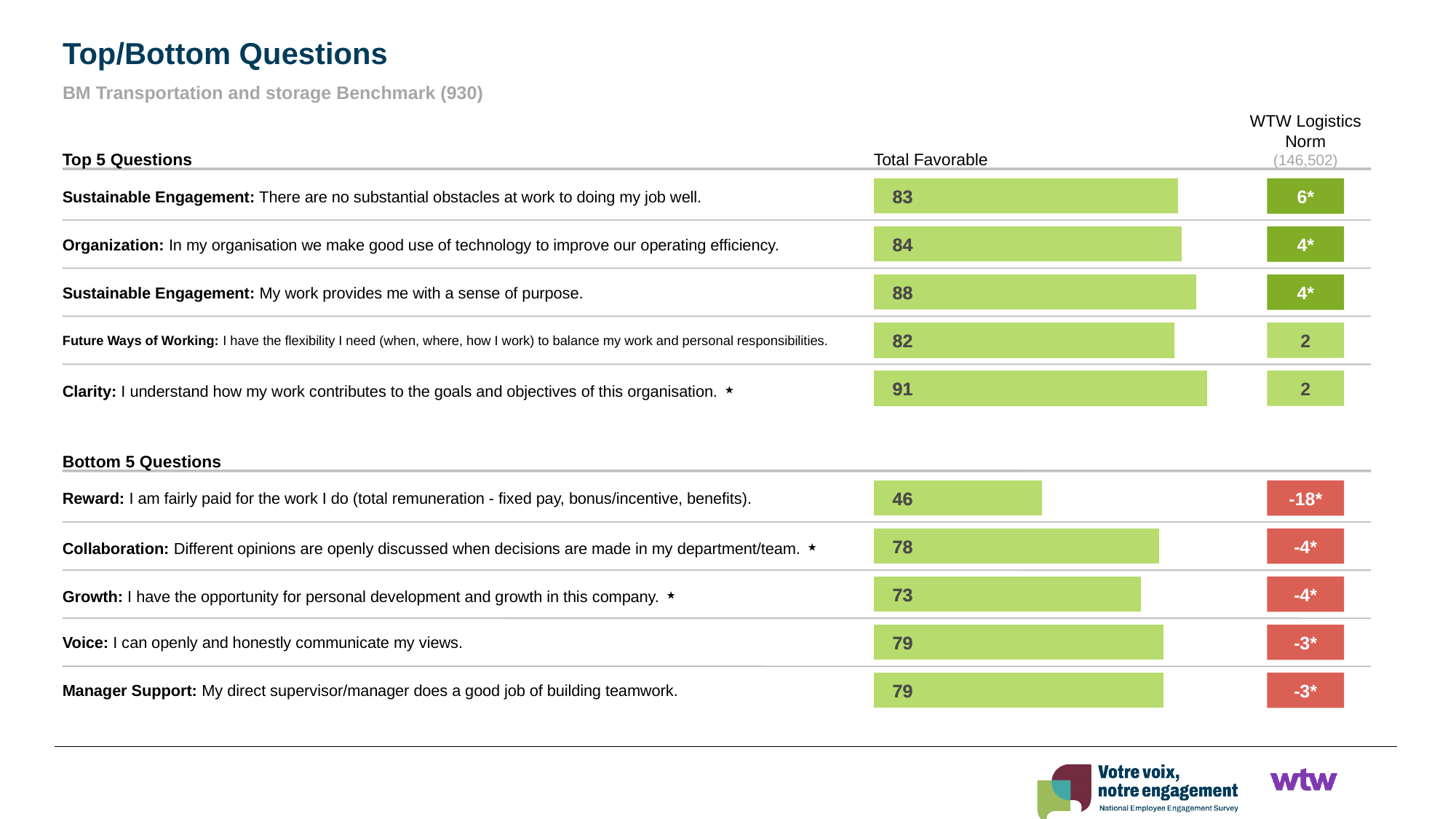
In the Top 5 Questions chart, what is the Total Favorable value for the Clarity item "I understand how my work contributes to the goals and objectives of this organisation"? 91 In the Top 5 Questions chart, which item has the highest Total Favorable value? Clarity: I understand how my work contributes to the goals and objectives of this organisation. In the Top 5 Questions chart, what is the difference in Total Favorable between the Clarity item (91) and the Future Ways of Working item (82)? 9 In the Top 5 Questions chart, what is the WTW Logistics Norm difference shown for the Sustainable Engagement item "There are no substantial obstacles at work to doing my job well"? 6* How many items are plotted in the Bottom 5 Questions chart? 5 In the Bottom 5 Questions chart, which has a larger Total Favorable value: the Collaboration item or the Growth item? Collaboration What is the sample size shown under the WTW Logistics Norm column header? (146,502) What kind of chart is used to show the Total Favorable values on this slide? Bar chart In the Bottom 5 Questions chart, what is the WTW Logistics Norm difference shown for the Reward item? -18* In the Bottom 5 Questions chart, which item has the lowest Total Favorable value? Reward: I am fairly paid for the work I do. In the Bottom 5 Questions chart, what is the Total Favorable value for the Reward item "I am fairly paid for the work I do"? 46 In the Bottom 5 Questions chart, what is the difference in Total Favorable between the Voice item (79) and the Growth item (73)? 6